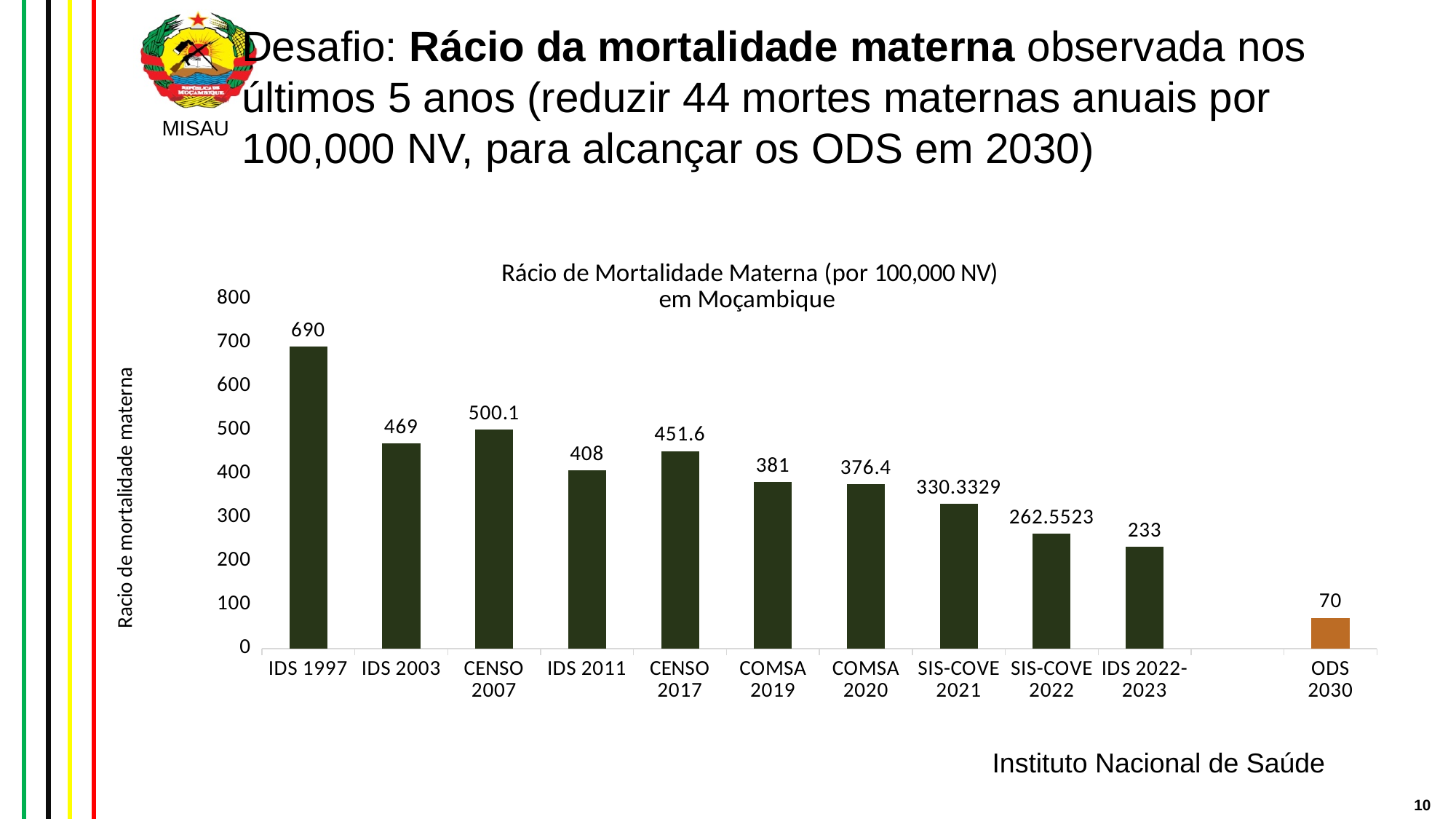
Which is larger, the value for CENSO 2017 or the value for COMSA 2019? CENSO 2017 What is the value for ODS 2030? 70 What is the value for SIS-COVE 2021? 330.3329 What is the value for IDS 1997? 690 Which category has the lowest value? ODS 2030 What is the difference between the values for IDS 2003 and IDS 2011? 61 What kind of chart is this? Bar chart What is the title of the chart? Rácio de Mortalidade Materna (por 100,000 NV) em Moçambique Which category has the highest value? IDS 1997 How many categories are shown on the x axis? 11 What is the value for CENSO 2007? 500.1 Do the values rise or fall from IDS 1997 to IDS 2022-2023? Fall